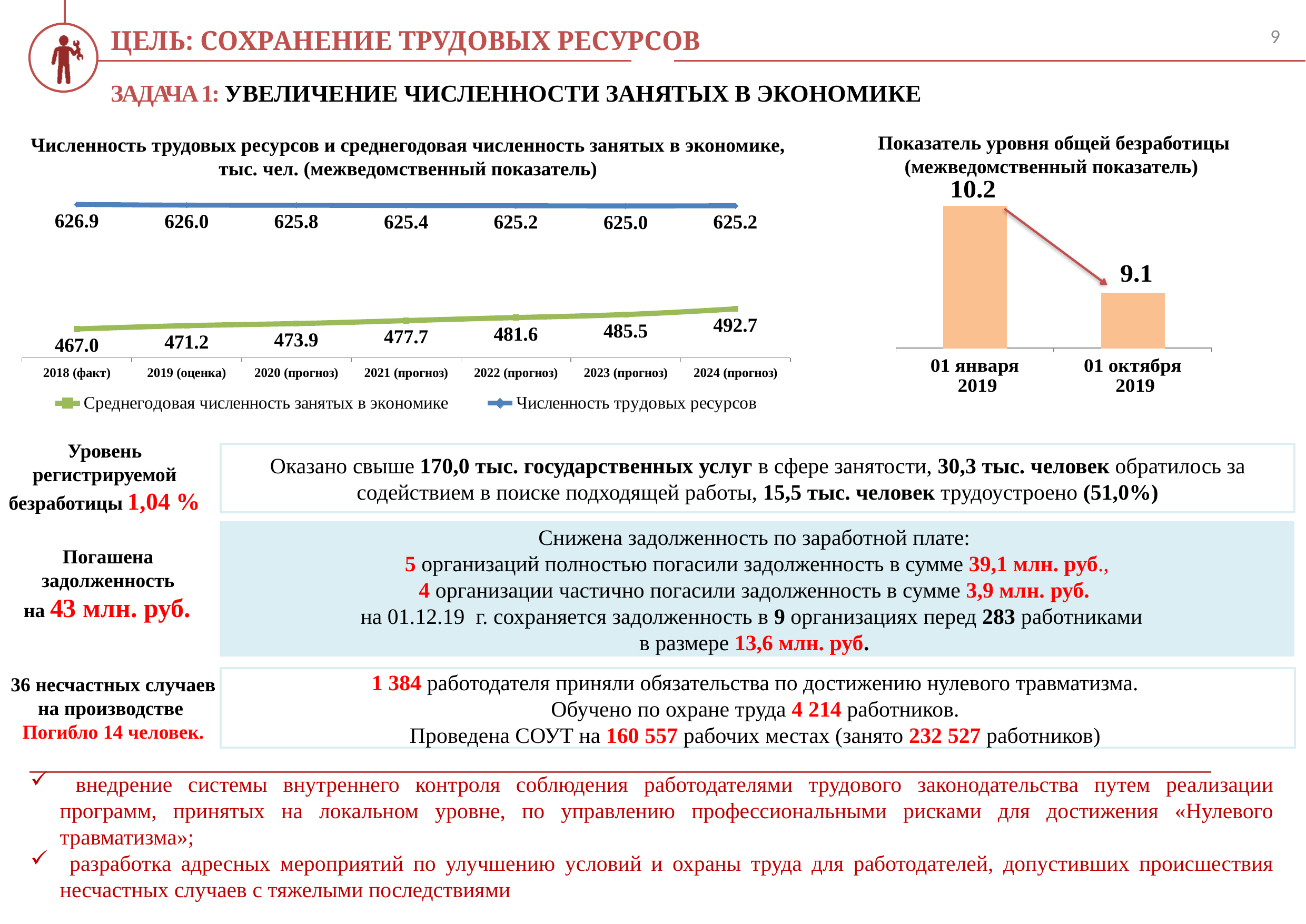
In the right chart 'Показатель уровня общей безработицы', what is the difference between the values for 01 января 2019 and 01 октября 2019? 1.1 In the left chart, what is the difference between 'Численность трудовых ресурсов' and 'Среднегодовая численность занятых в экономике' in 2018 (факт)? 159.9 In the left chart, does 'Среднегодовая численность занятых в экономике' rise or fall from 2018 to 2024? rise In the left chart, in which year is 'Среднегодовая численность занятых в экономике' highest? 2024 (прогноз) In the left chart, in which year is 'Численность трудовых ресурсов' highest? 2018 (факт) In the left chart 'Численность трудовых ресурсов и среднегодовая численность занятых в экономике', what is the value of 'Среднегодовая численность занятых в экономике' for 2018 (факт)? 467.0 In the left chart, what is the value of 'Численность трудовых ресурсов' for 2024 (прогноз)? 625.2 How many years are shown on the x axis of the left chart? 7 How many series does the legend of the left chart list? 2 In the right chart 'Показатель уровня общей безработицы', what is the value for 01 октября 2019? 9.1 What kind of chart is the right chart 'Показатель уровня общей безработицы'? bar chart In the left chart, what is the value of 'Среднегодовая численность занятых в экономике' for 2022 (прогноз)? 481.6